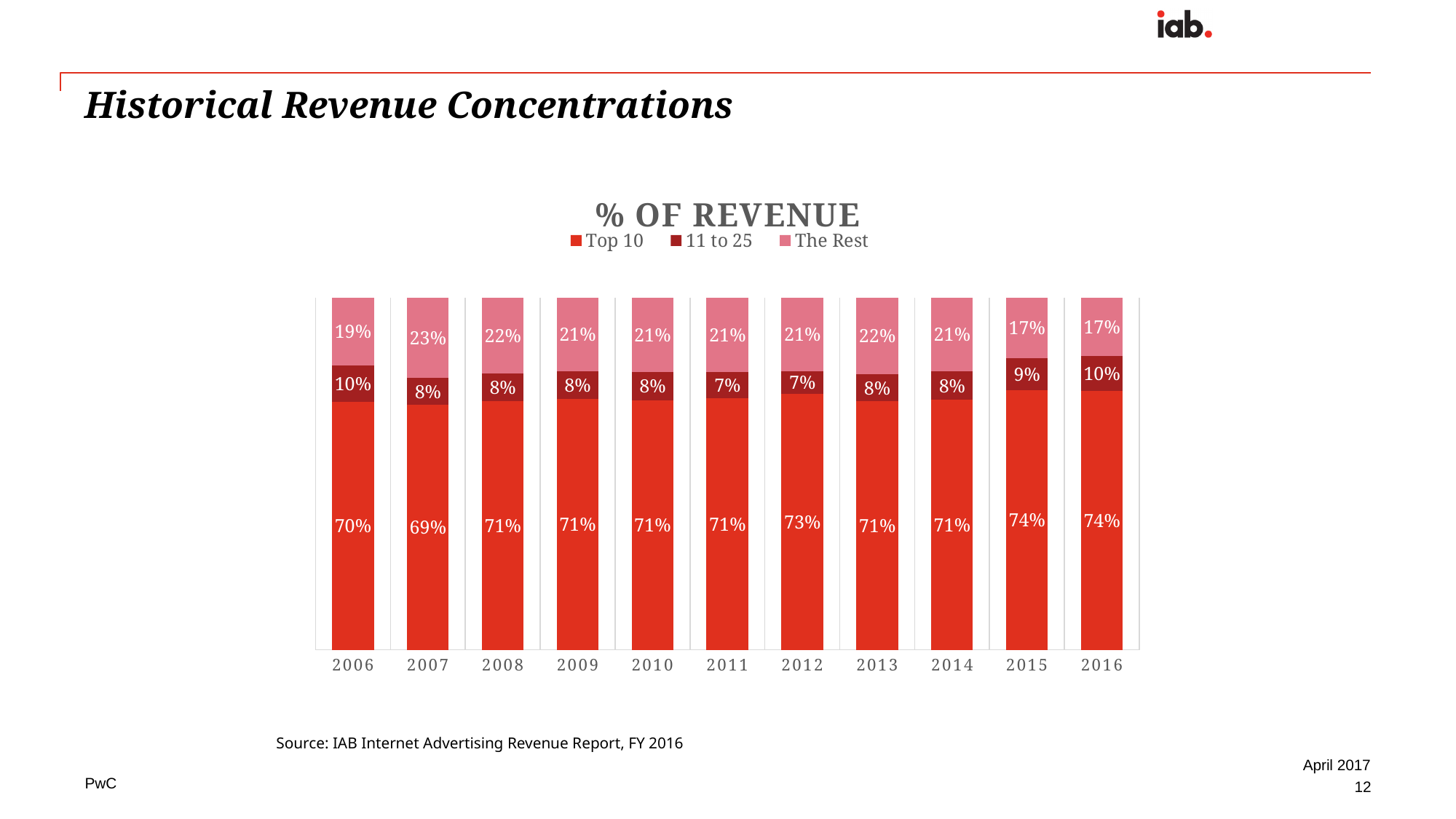
What is the title of the chart? % OF REVENUE In which year is the Top 10 share lowest? 2007 By how many percentage points did the Top 10 share change from 2006 to 2016? 4 percentage points Which is larger, The Rest in 2006 or The Rest in 2016? The Rest in 2006 What is the value for The Rest in 2007? 23% How many series does the legend list? 3 How many years are shown on the x axis? 11 What is the Top 10 share of revenue in 2012? 73% What type of chart is shown on the slide? Stacked bar chart Does the Top 10 share generally rise or fall from 2006 to 2016? Rise What is the value for 11 to 25 in 2015? 9% In which year is The Rest share highest? 2007